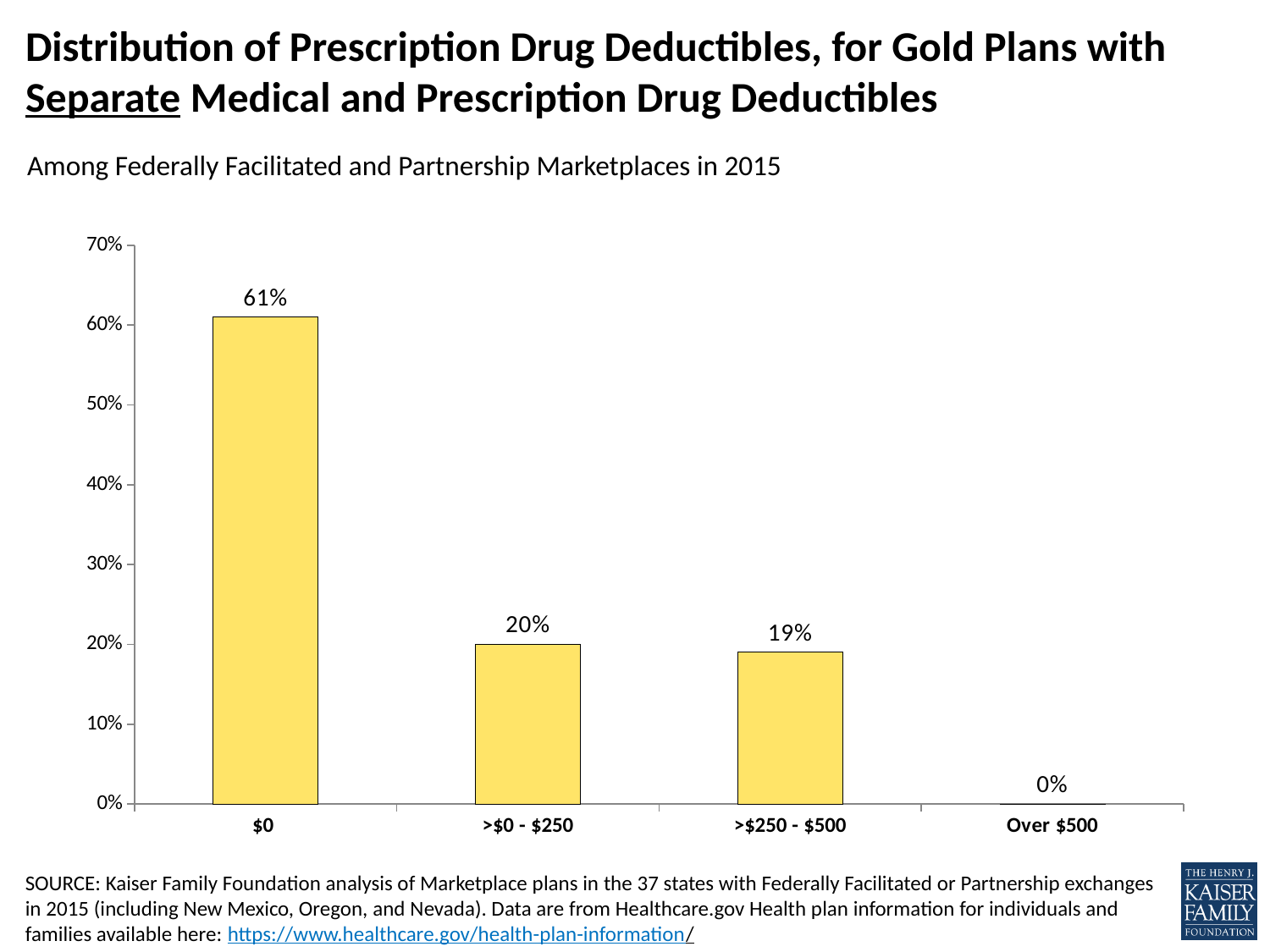
What is the highest value shown on the y axis? 70% What is the difference between the >$0 - $250 category and the >$250 - $500 category? 1% Which is larger, the value for $0 or the value for >$250 - $500? $0 What is the value for the Over $500 category? 0% What is the value for the >$250 - $500 category? 19% Which deductible category has the highest share of plans? $0 What type of chart is shown on the slide? Bar chart What is the difference between the $0 category and the >$0 - $250 category? 41% What is the value for the >$0 - $250 category? 20% What percentage of gold plans with separate deductibles have a $0 prescription drug deductible? 61% Which deductible category has the lowest share of plans? Over $500 How many deductible categories are shown on the x axis? 4